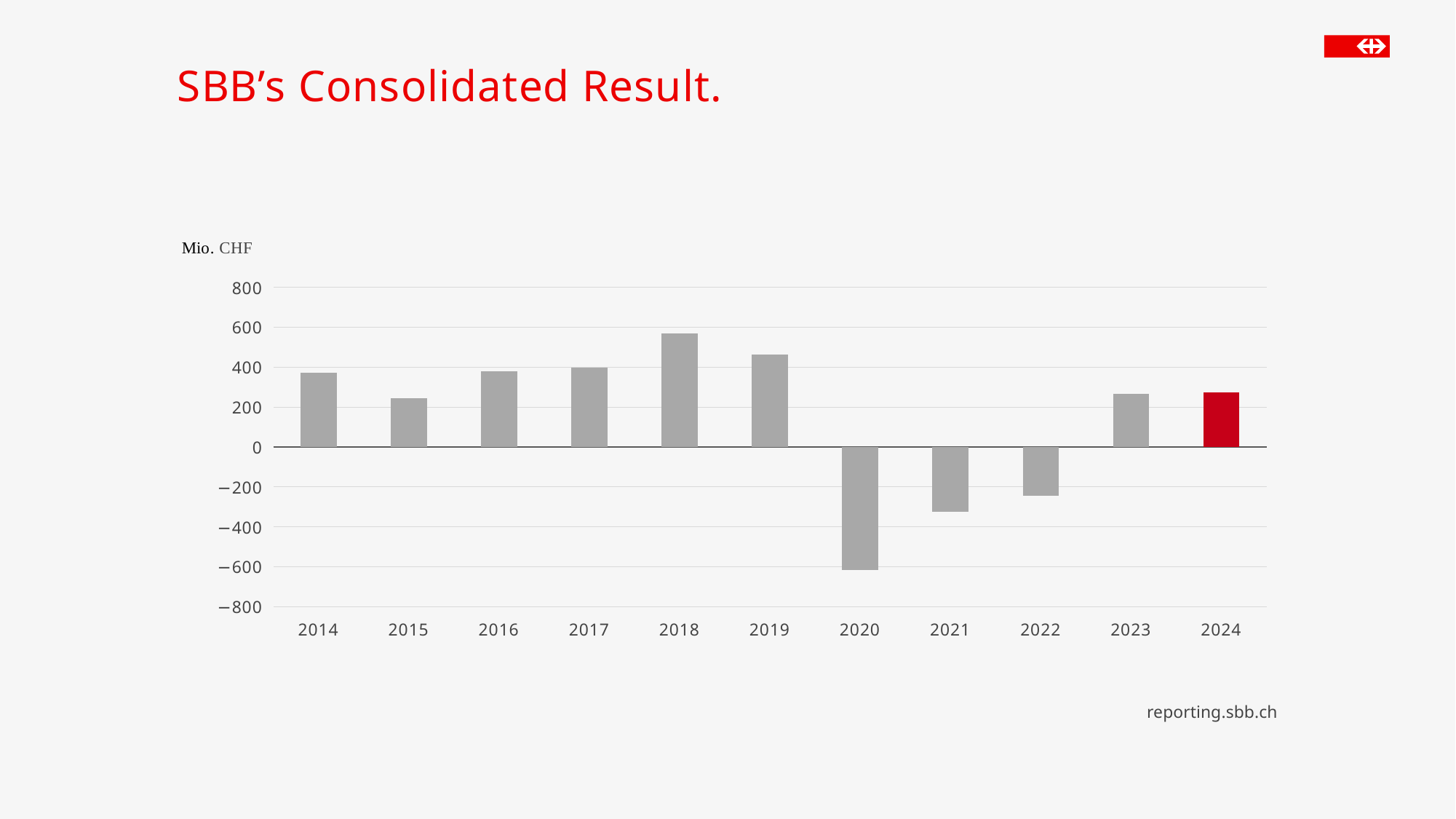
Is the value for 2021 greater or less than -200? less How many years are plotted on the chart? 11 Is the value for 2018 greater or less than 400? greater What kind of chart is shown on the slide? bar chart Which year has the larger value, 2018 or 2019? 2018 Do the values rise or fall from 2020 to 2024? rise Is the value for 2020 greater or less than -400? less Which year has the larger value, 2014 or 2015? 2014 Which year has the lowest consolidated result? 2020 Which year has the highest consolidated result? 2018 Which year's bar is coloured red instead of grey? 2024